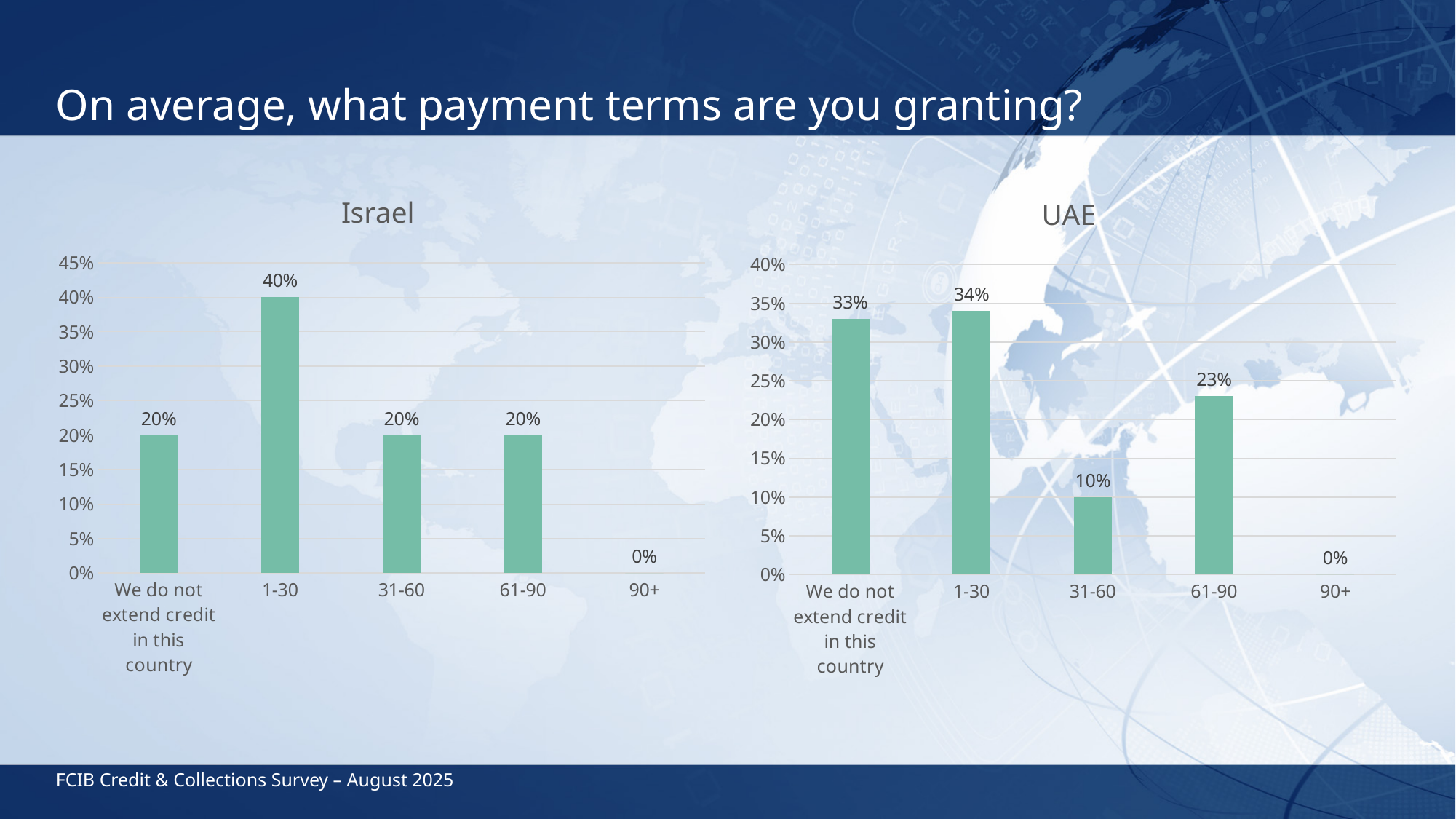
How many categories are shown on the x axis of the UAE chart? 5 In the Israel chart, what is the value for 1-30? 40% In the Israel chart, which category has the highest value? 1-30 In the Israel chart, what is the difference between the values for 1-30 and 31-60? 20% In the UAE chart, which category has the lowest value? 90+ In the UAE chart, what is the value for 'We do not extend credit in this country'? 33% In the UAE chart, what is the value for 61-90? 23% In the UAE chart, what is the difference between the values for 1-30 and 31-60? 24% Is the value for 1-30 in the Israel chart greater or less than 35%? greater What is the title of the chart on the right side of the slide? UAE What type of chart is the Israel chart? bar chart In the UAE chart, which is larger, the value for 61-90 or the value for 31-60? 61-90